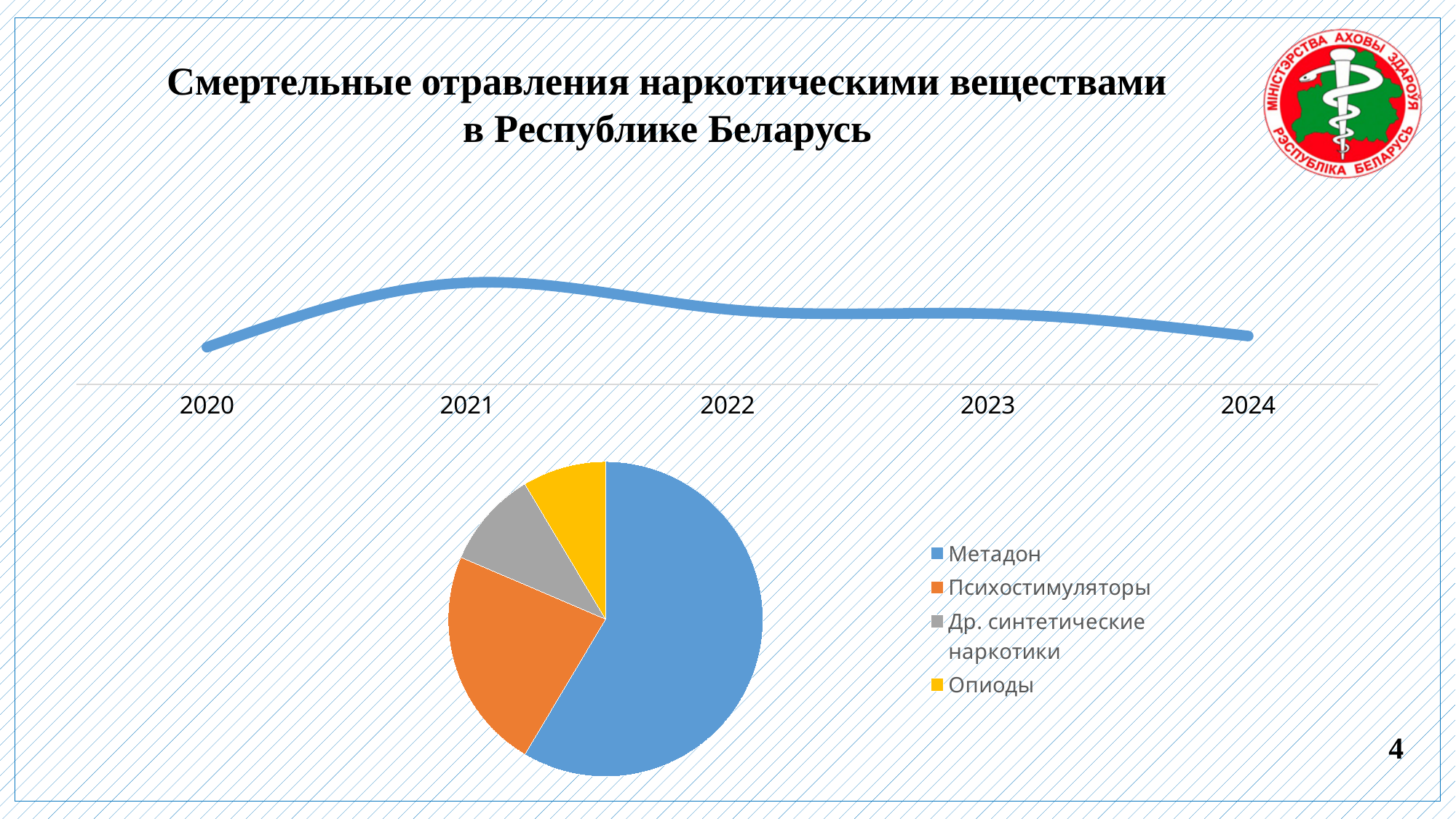
In the bottom pie chart, which category has the largest slice? Метадон In the top line chart, which is larger, the value for 2021 or the value for 2024? 2021 What is the title of the slide? Смертельные отравления наркотическими веществами в Республике Беларусь In the top line chart, which year has the highest value? 2021 What kind of chart is the bottom chart on the slide? pie chart In the top line chart, do the values rise or fall from 2021 to 2024? fall In the bottom pie chart, what colour is the slice for Опиоды? yellow In the bottom pie chart, which slice is larger, Метадон or Психостимуляторы? Метадон In the top line chart, how many years are shown on the x axis? 5 In the bottom pie chart, how many categories does the legend list? 4 In the top line chart, do the values rise or fall from 2020 to 2021? rise What kind of chart is the top chart on the slide? line chart